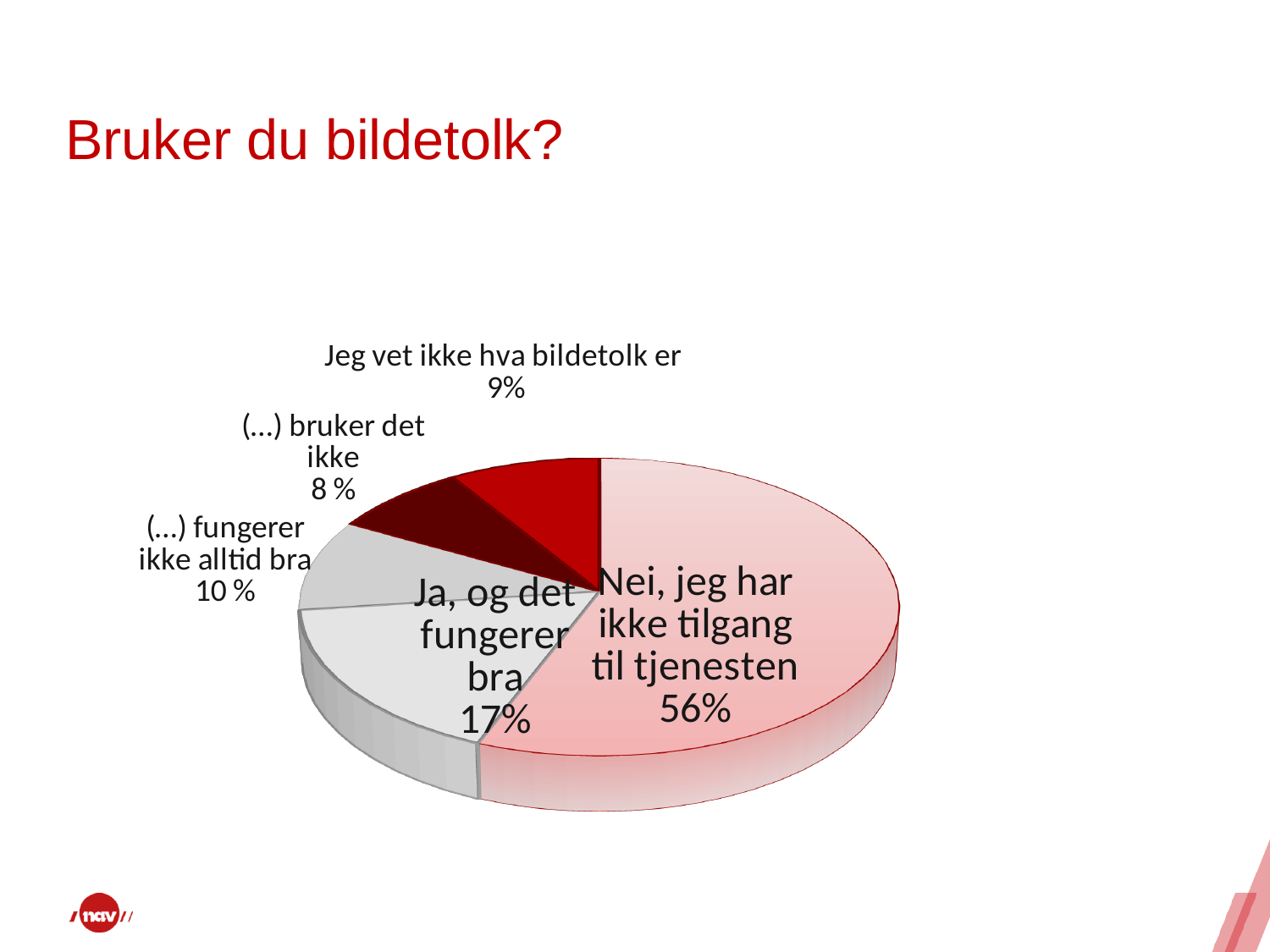
What kind of chart is shown on the slide? pie chart How many slices does the pie chart have? 5 Which slice of the pie is the largest? Nei, jeg har ikke tilgang til tjenesten What share of the pie is labelled "Nei, jeg har ikke tilgang til tjenesten"? 56% What share of the pie is labelled "Ja, og det fungerer bra"? 17% What share of the pie is labelled "Jeg vet ikke hva bildetolk er"? 9% What is the difference in percentage points between "Nei, jeg har ikke tilgang til tjenesten" and "Ja, og det fungerer bra"? 39 What share of the pie is labelled "(…) bruker det ikke"? 8 % Which is larger: the share for "Jeg vet ikke hva bildetolk er" or the share for "(…) bruker det ikke"? Jeg vet ikke hva bildetolk er What is the title of the slide above the chart? Bruker du bildetolk? What share of the pie is labelled "(…) fungerer ikke alltid bra"? 10 % Which slice of the pie is the smallest? (…) bruker det ikke